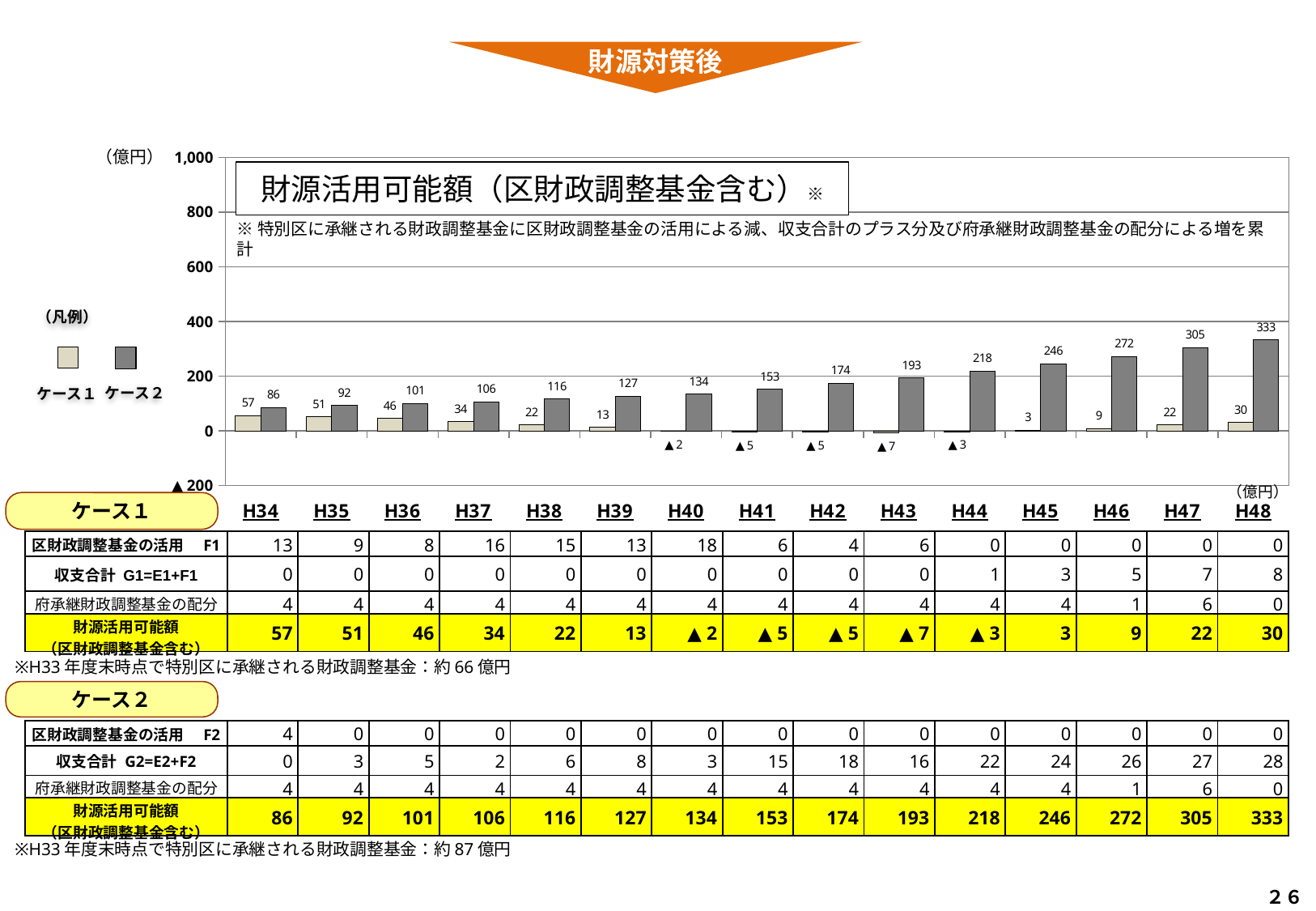
What is the difference between the ケース2 and ケース1 values in H48? 303 In H40, which is larger, ケース1 or ケース2? ケース2 In which year is the ケース2 value highest? H48 How many series does the legend list? 2 Is the value for ケース2 in H44 greater or less than 200? greater What is the value for ケース2 in H48? 333 In which year is the ケース1 value lowest? H43 What is the value for ケース1 in H40? ▲2 What kind of chart is shown on the slide? bar chart How many years are shown on the x axis of the chart? 15 What is the value for ケース1 in H34? 57 Do the ケース2 values rise or fall from H34 to H48? rise